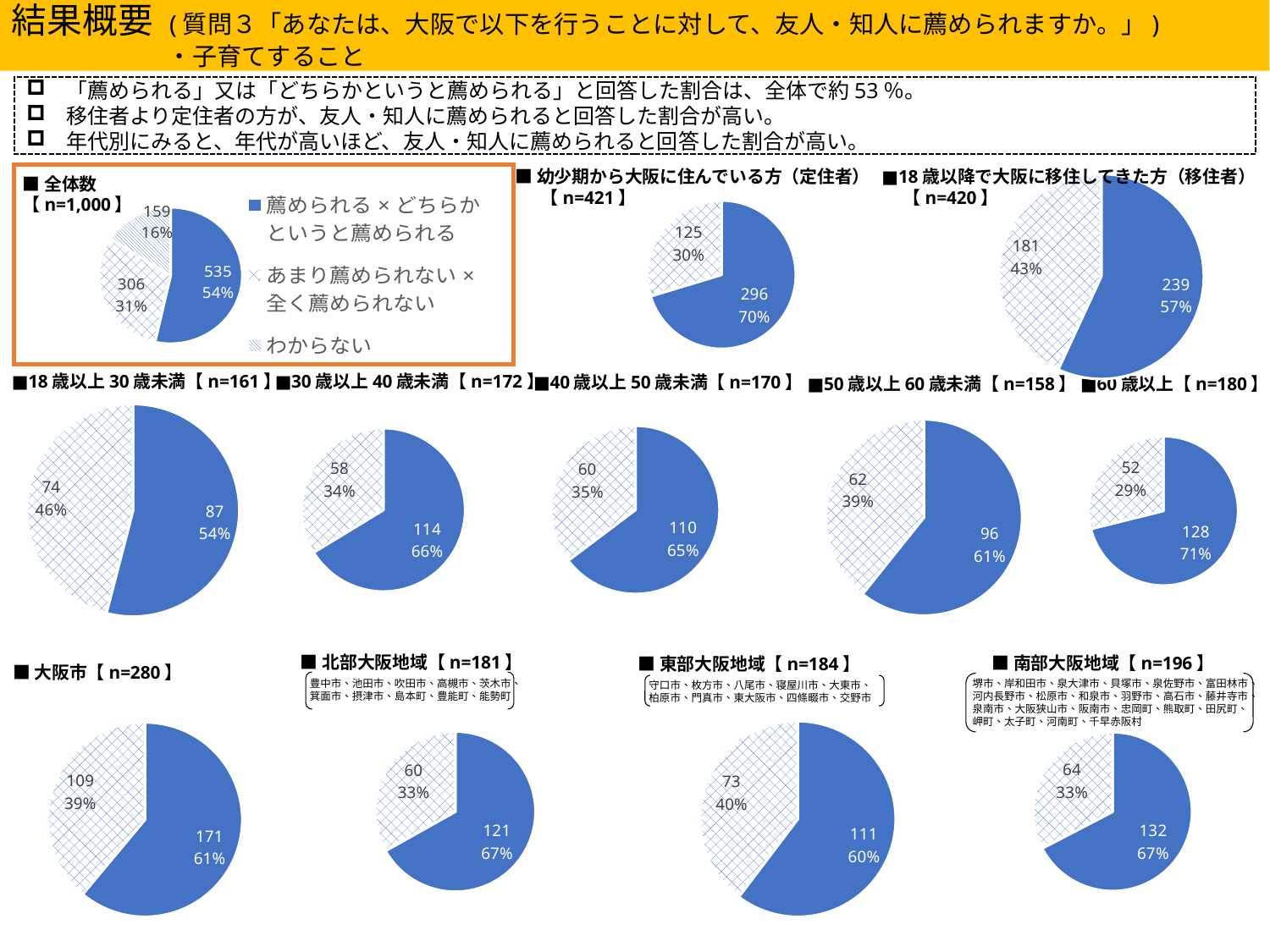
「大阪市【n=280】」の円グラフで、青色の部分（薦められる）の回答数と、もう一方の部分の回答数の差はいくつですか。 62 「幼少期から大阪に住んでいる方（定住者）【n=421】」の円グラフで、青色の部分（薦められる）の割合は何％ですか。 70% 年代別の5つの円グラフのうち、青色の部分（薦められる）の割合が最も低いのはどの年代ですか。 18歳以上30歳未満 「全体数【n=1,000】」の円グラフで、「薦められる × どちらかというと薦められる」の回答数はいくつですか。 535 「東部大阪地域【n=184】」の円グラフで、青色の部分（薦められる）の割合は何％ですか。 60% 「全体数【n=1,000】」の円グラフで、「わからない」の割合は何％ですか。 16% 「全体数【n=1,000】」の円グラフの凡例には、いくつの項目がありますか。 3 「幼少期から大阪に住んでいる方（定住者）」と「18歳以降で大阪に移住してきた方（移住者）」の円グラフで、青色の部分（薦められる）の割合はどちらが大きいですか。 幼少期から大阪に住んでいる方（定住者） 年代別の5つの円グラフのうち、青色の部分（薦められる）の割合が最も高いのはどの年代ですか。 60歳以上 このスライドに使われているグラフの種類は何ですか。 円グラフ 「30歳以上40歳未満【n=172】」の円グラフで、青色の部分（薦められる）の回答数はいくつですか。 114 「18歳以降で大阪に移住してきた方（移住者）【n=420】」の円グラフで、青色の部分（薦められる）の回答数はいくつですか。 239